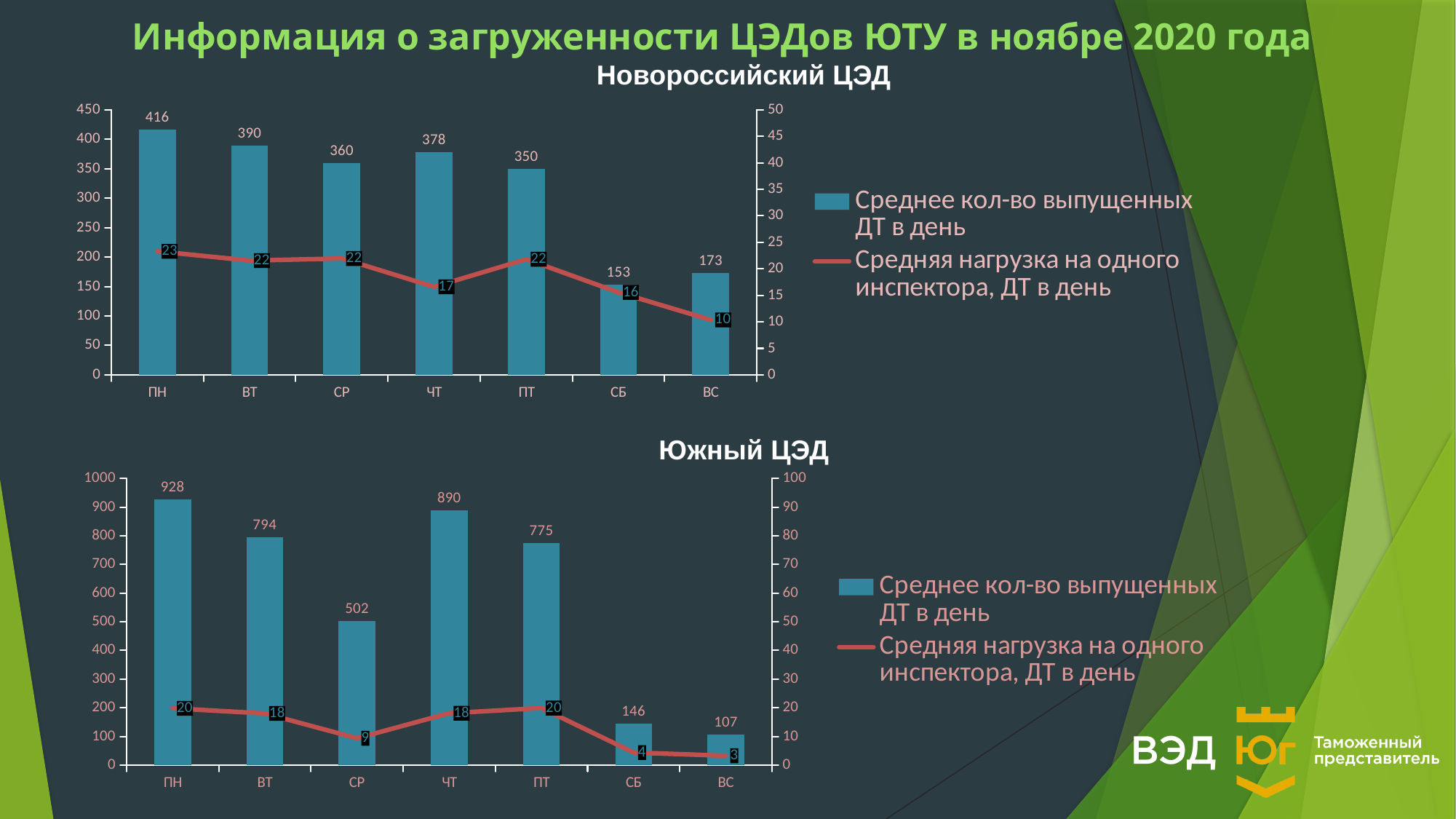
In the Новороссийский ЦЭД chart, how many series does the legend list? 2 How many days (categories) are shown on the x axis of the Южный ЦЭД chart? 7 In the Южный ЦЭД chart, what is the average load per inspector on ВС? 3 In the Южный ЦЭД chart, what is the difference between the bar values for ПН and СР? 426 In the Южный ЦЭД chart, which is larger, the bar value for ВТ or for ПТ? ВТ In the Новороссийский ЦЭД chart, what colour is the line for average load per inspector? Red In the Южный ЦЭД chart, which day has the highest average number of released ДТ per day? ПН In the Новороссийский ЦЭД chart, what is the average number of released ДТ per day on ПН? 416 In the Новороссийский ЦЭД chart, what is the average load per inspector on ЧТ? 17 In the Новороссийский ЦЭД chart, what is the difference between the bar values for ПН and ВС? 243 In the Новороссийский ЦЭД chart, which day has the lowest average number of released ДТ per day? СБ In the Южный ЦЭД chart, what is the average number of released ДТ per day on ЧТ? 890